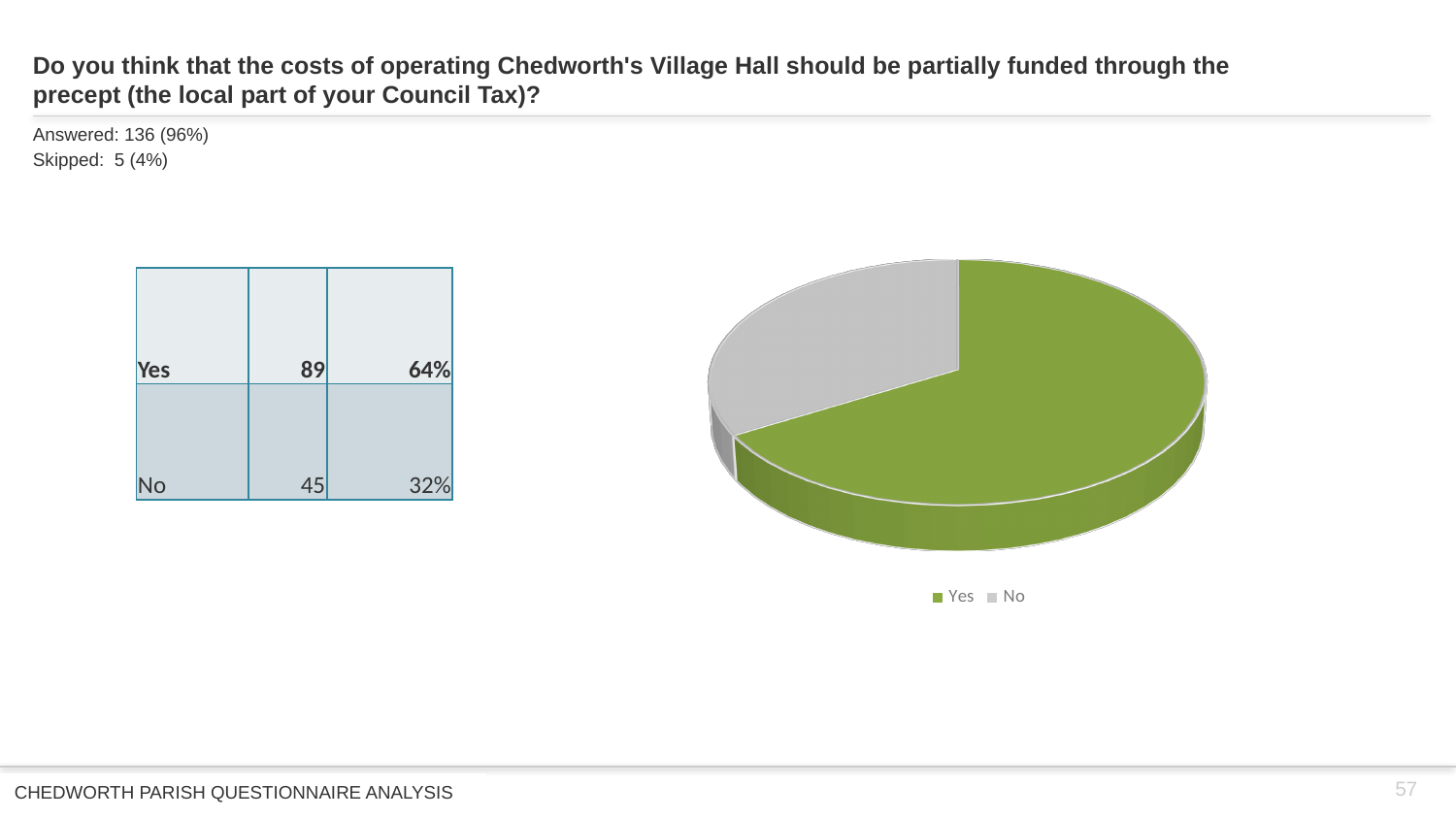
Which response has the largest slice in the pie chart? Yes How many slices does the pie chart have? 2 According to the table on the slide, how many respondents answered No? 45 What kind of chart is shown on the slide? pie chart How many series does the pie chart's legend list? 2 According to the table on the slide, how many respondents answered Yes? 89 Is the Yes slice or the No slice larger in the pie chart? Yes What share of the pie does the Yes slice represent, as shown in the table? 64% What share of the pie does the No slice represent, as shown in the table? 32% What is the difference between the number of Yes and No responses shown in the table? 44 Which response has the smallest slice in the pie chart? No What colour is the Yes slice in the pie chart? green